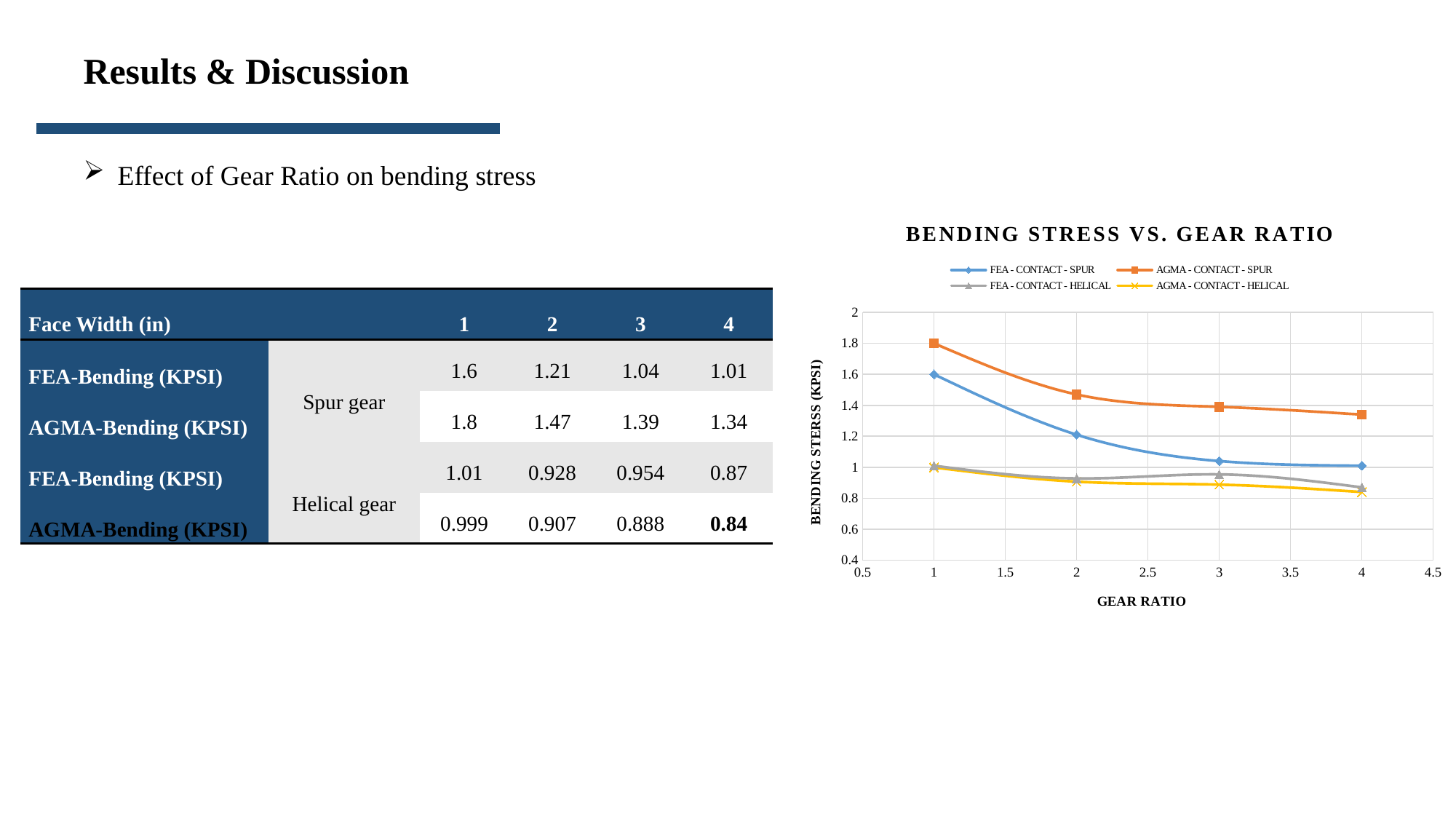
What is the label of the x axis of the chart? GEAR RATIO What is the value of FEA - CONTACT - SPUR at gear ratio 1? 1.6 At gear ratio 2, which is larger: FEA - CONTACT - SPUR or AGMA - CONTACT - SPUR? AGMA - CONTACT - SPUR Is the value for FEA - CONTACT - HELICAL at gear ratio 4 greater or less than 1? less What is the title of the chart? BENDING STRESS VS. GEAR RATIO What is the value of AGMA - CONTACT - SPUR at gear ratio 1? 1.8 How many series does the chart legend list? 4 What kind of chart is shown on the slide? Line chart Does the AGMA - CONTACT - SPUR series rise or fall as gear ratio increases? Fall How many data points does each series in the chart have? 4 Is the value for AGMA - CONTACT - SPUR at gear ratio 3 greater or less than 1.2? greater Which series has the highest value at gear ratio 1? AGMA - CONTACT - SPUR